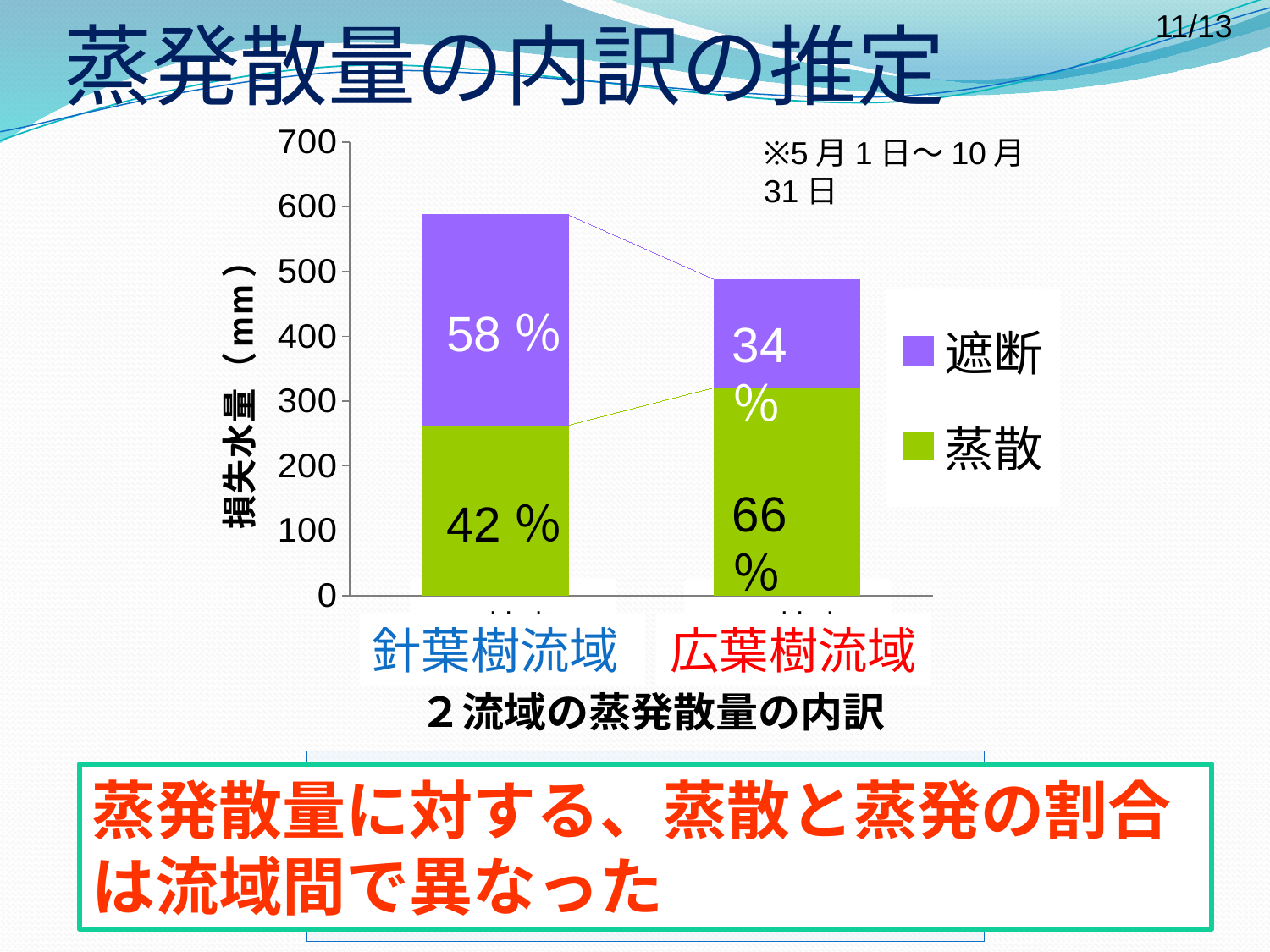
How many series does the legend list? 2 What percentage label is shown on the 蒸散 segment for 広葉樹流域? 66 % What kind of chart is shown on the slide? Stacked bar chart Which watershed has the taller total bar, 針葉樹流域 or 広葉樹流域? 針葉樹流域 What percentage label is shown on the 蒸散 segment for 針葉樹流域? 42 % Is the 蒸散 segment for 針葉樹流域 greater or less than 300 mm? less Is the 蒸散 segment for 広葉樹流域 greater or less than 300 mm? greater What is the label of the vertical axis? 損失水量（mm） What percentage label is shown on the 遮断 segment for 針葉樹流域? 58 % Is the total bar height for 針葉樹流域 greater or less than 500 mm? greater What percentage label is shown on the 遮断 segment for 広葉樹流域? 34 %